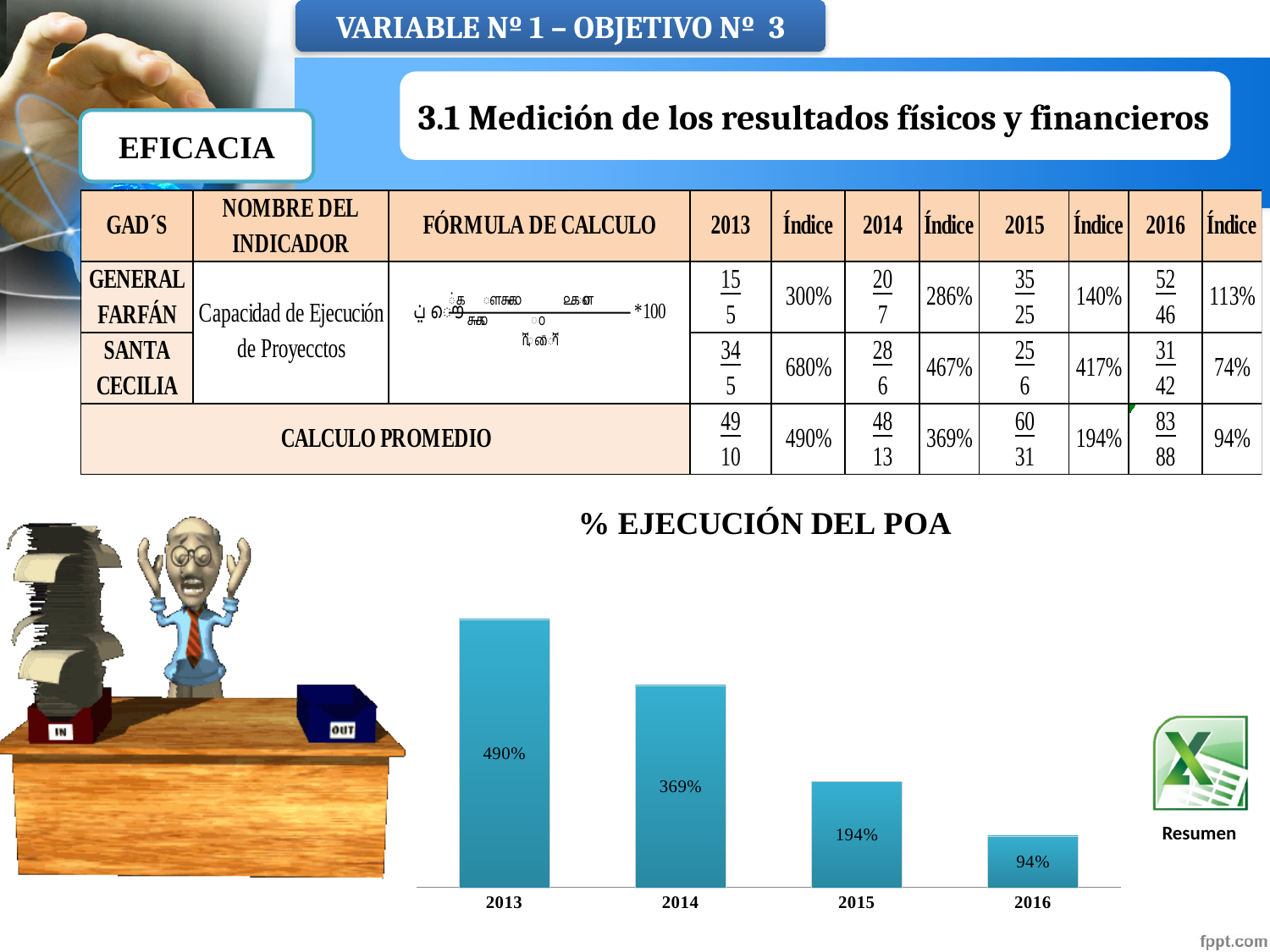
What is the title of the chart on the slide? % EJECUCIÓN DEL POA What is the difference between the values for 2013 and 2016? 396% What is the value for 2014 in the chart? 369% What is the value for 2016 in the chart? 94% What is the value for 2013 in the chart? 490% Which year has the highest value in the chart? 2013 How many years are shown on the x axis of the chart? 4 What is the value for 2015 in the chart? 194% Do the values rise or fall from 2013 to 2016? fall Which is larger, the value for 2014 or the value for 2015? 2014 What type of chart is shown on the slide? bar chart Which year has the lowest value in the chart? 2016